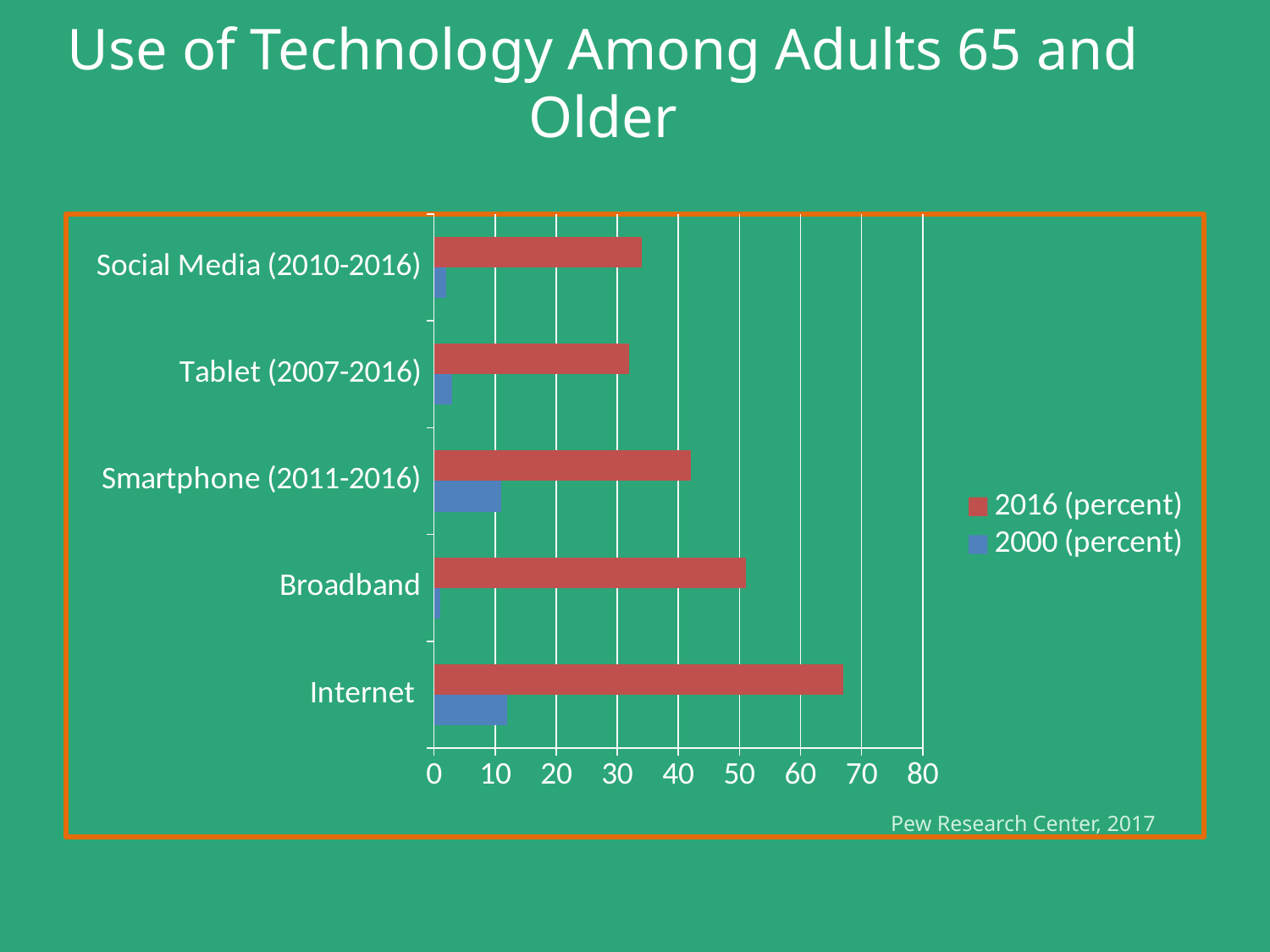
Is the 2016 (percent) value for Broadband greater or less than 40? greater What kind of chart is shown on the slide? Bar chart Is the 2000 (percent) value for Smartphone (2011-2016) greater or less than 20? less How many series does the legend list? 2 Which is larger for the 2016 (percent) series: Smartphone (2011-2016) or Tablet (2007-2016)? Smartphone (2011-2016) How many technology categories are shown on the chart? 5 Which category has the highest value for the 2016 (percent) series? Internet What source is cited below the chart? Pew Research Center, 2017 Is the 2016 (percent) value for Internet greater or less than 60? greater Which is larger for the 2016 (percent) series: Internet or Broadband? Internet Which is larger for the 2000 (percent) series: Smartphone (2011-2016) or Tablet (2007-2016)? Smartphone (2011-2016)